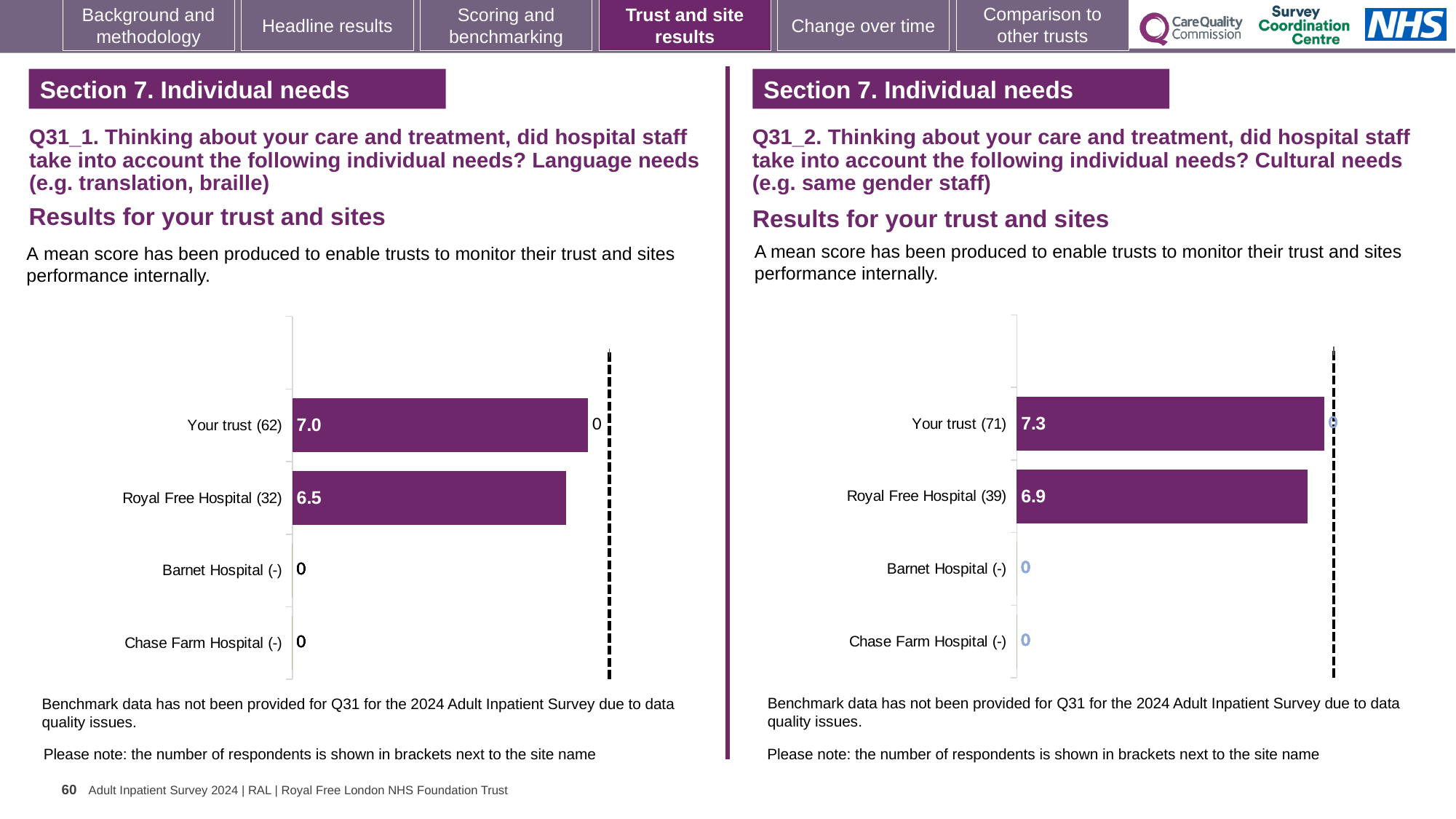
In the left chart (Q31_1, Language needs), what is the mean score for Royal Free Hospital? 6.5 In the right chart (Q31_2, Cultural needs), what is the mean score for Royal Free Hospital? 6.9 In the left chart (Q31_1, Language needs), what is the difference between the scores for Your trust and Royal Free Hospital? 0.5 In the left chart (Q31_1, Language needs), how many respondents are shown in brackets for Royal Free Hospital? 32 In the right chart (Q31_2, Cultural needs), which has the higher score: Your trust or Royal Free Hospital? Your trust What type of chart is used in the right chart (Q31_2, Cultural needs)? Bar chart In the left chart (Q31_1, Language needs), which category has the highest score? Your trust How many categories are shown in the left chart (Q31_1, Language needs)? 4 In the left chart (Q31_1, Language needs), what is the mean score for Your trust? 7.0 In the right chart (Q31_2, Cultural needs), what is the mean score for Your trust? 7.3 In the right chart (Q31_2, Cultural needs), what is the difference between the scores for Your trust and Royal Free Hospital? 0.4 In the right chart (Q31_2, Cultural needs), how many respondents are shown in brackets for Your trust? 71